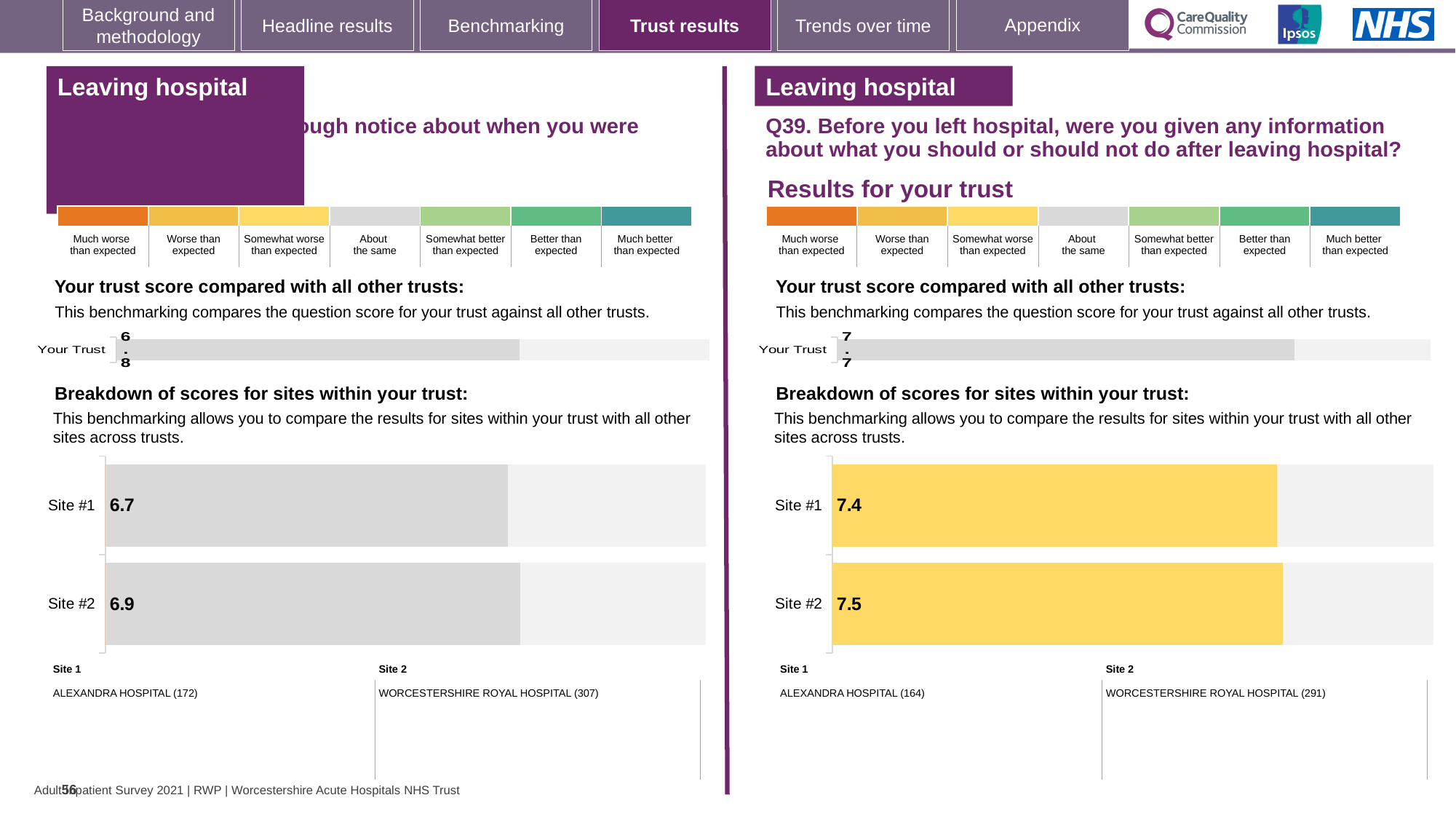
On the right-hand side of the slide (Q39), what is the 'Your Trust' score shown in the trust score comparison chart? 7.7 On the right-hand side of the slide (Q39), what is the score for Site #2 in the breakdown of scores for sites within your trust? 7.5 On the left-hand side of the slide, what is the score for Site #1 in the breakdown of scores for sites within your trust? 6.7 How many sites are shown in the site breakdown chart on the right-hand side of the slide (Q39)? 2 On the right-hand side of the slide (Q39), what is the score for Site #1 in the breakdown of scores for sites within your trust? 7.4 On the left-hand side of the slide, which site has the lower score in the site breakdown chart? Site #1 On the left-hand side of the slide, what is the 'Your Trust' score shown in the trust score comparison chart? 6.8 On the right-hand side of the slide (Q39), which site has the higher score in the site breakdown chart? Site #2 On the right-hand side of the slide (Q39), what is the difference between the Site #2 score and the Site #1 score? 0.1 What type of chart is used for the breakdown of scores for sites within your trust on the right-hand side of the slide (Q39)? Bar chart On the left-hand side of the slide, what is the score for Site #2 in the breakdown of scores for sites within your trust? 6.9 On the left-hand side of the slide, what is the difference between the Site #2 score and the Site #1 score? 0.2